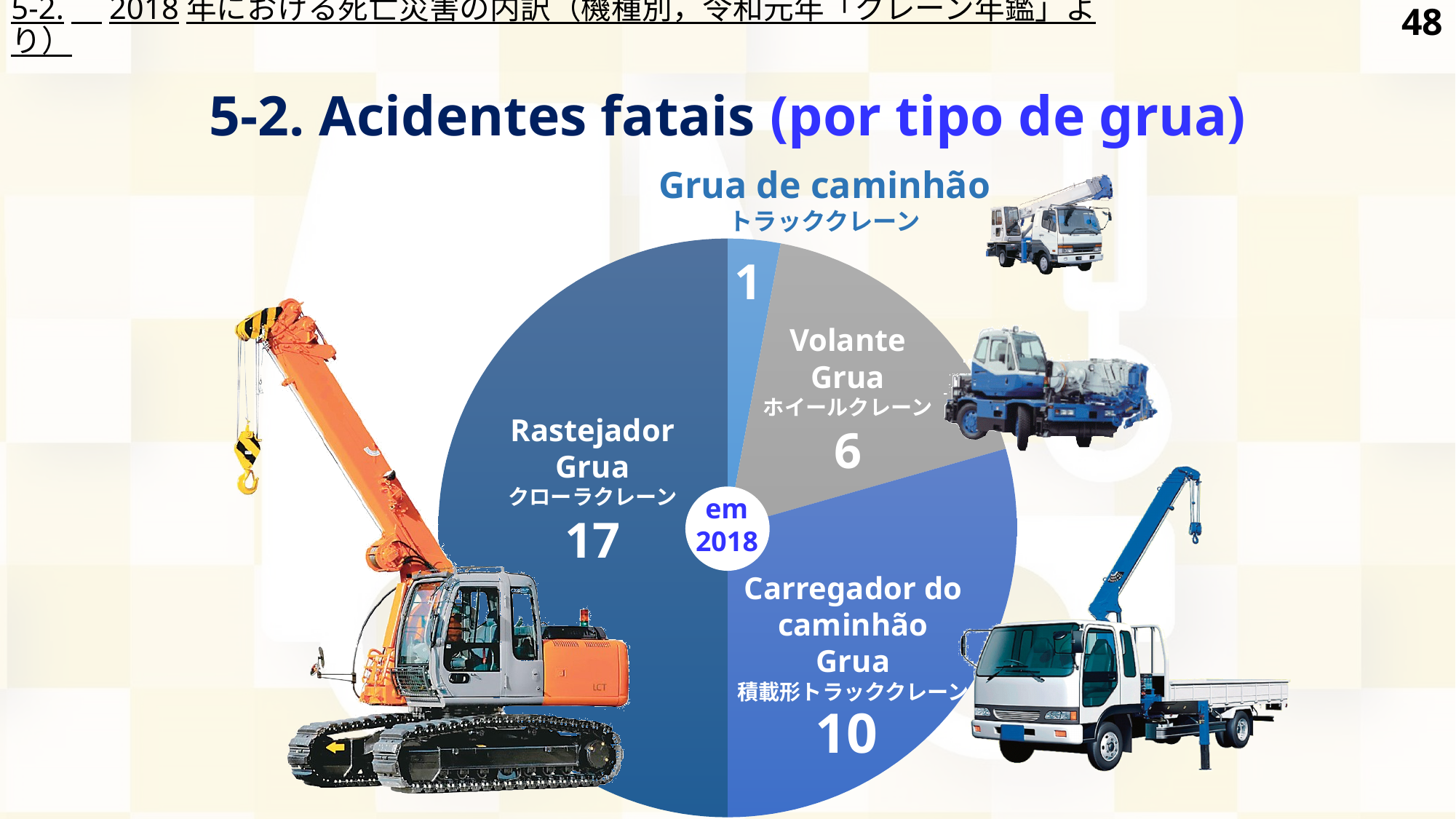
How many fatal accidents are shown for Carregador do caminhão Grua? 10 Which crane type has the highest number of fatal accidents? Rastejador Grua What is the total number of fatal accidents across all slices of the pie chart? 34 Which crane type has the lowest number of fatal accidents? Grua de caminhão What share of the pie does Rastejador Grua represent? 50% How many fatal accidents are shown for Rastejador Grua? 17 What kind of chart is shown on the slide? pie chart How many crane types are shown in the pie chart? 4 How many fatal accidents are shown for Grua de caminhão? 1 Which has more fatal accidents, Volante Grua or Carregador do caminhão Grua? Carregador do caminhão Grua How many fatal accidents are shown for Volante Grua? 6 What is the difference between the fatal accidents for Rastejador Grua and Carregador do caminhão Grua? 7